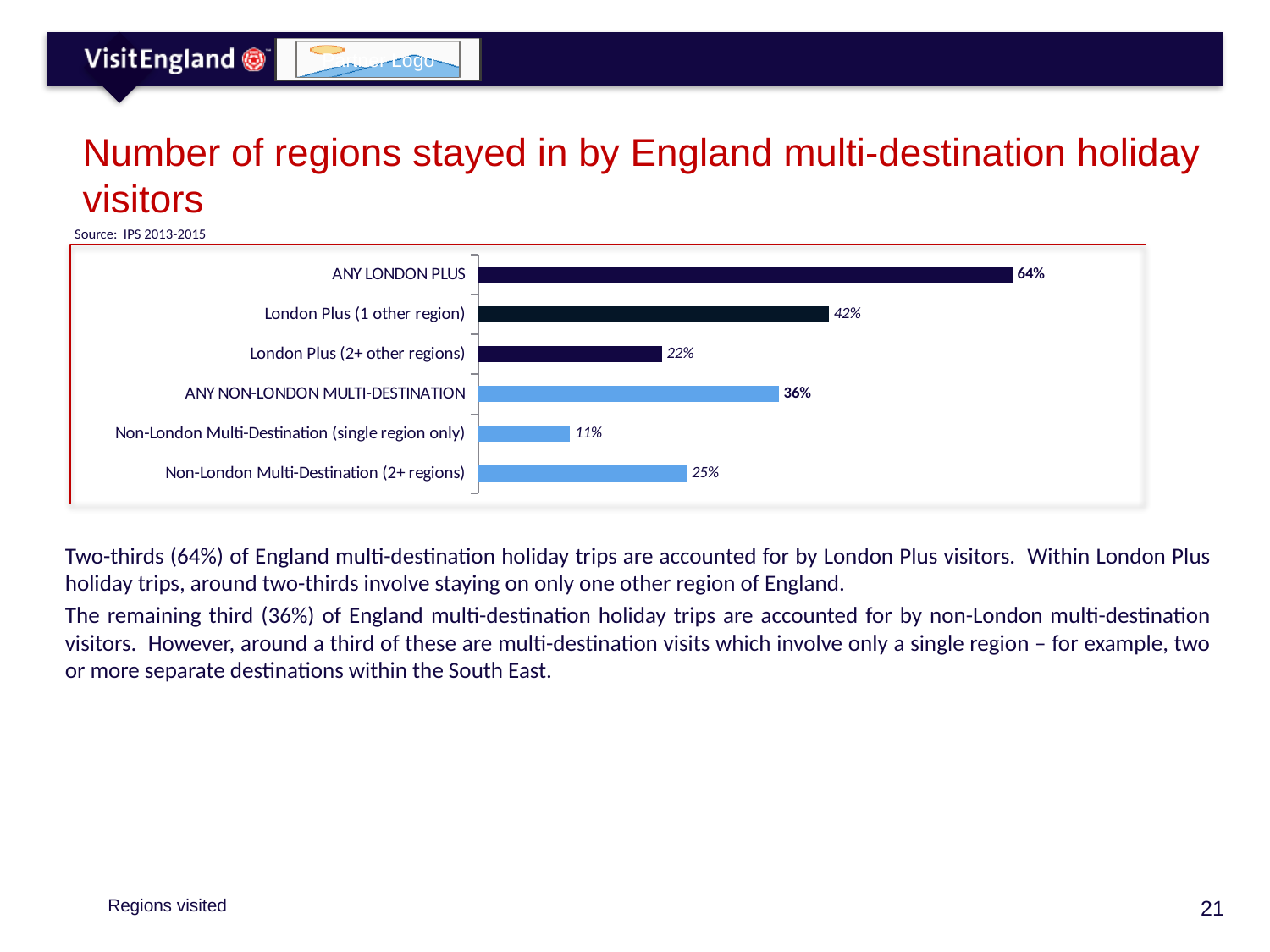
What is the difference between ANY LONDON PLUS and ANY NON-LONDON MULTI-DESTINATION? 28% What kind of chart is shown on the slide? Bar chart Which category has the lowest value? Non-London Multi-Destination (single region only) What is the value for Non-London Multi-Destination (single region only)? 11% How many categories are shown in the chart? 6 What is the value for ANY NON-LONDON MULTI-DESTINATION? 36% What is the difference between London Plus (1 other region) and London Plus (2+ other regions)? 20% What is the value for ANY LONDON PLUS? 64% Which category has the highest value? ANY LONDON PLUS Which is larger: Non-London Multi-Destination (2+ regions) or London Plus (2+ other regions)? Non-London Multi-Destination (2+ regions) What is the value for London Plus (1 other region)? 42% What is the source cited for the chart? IPS 2013-2015